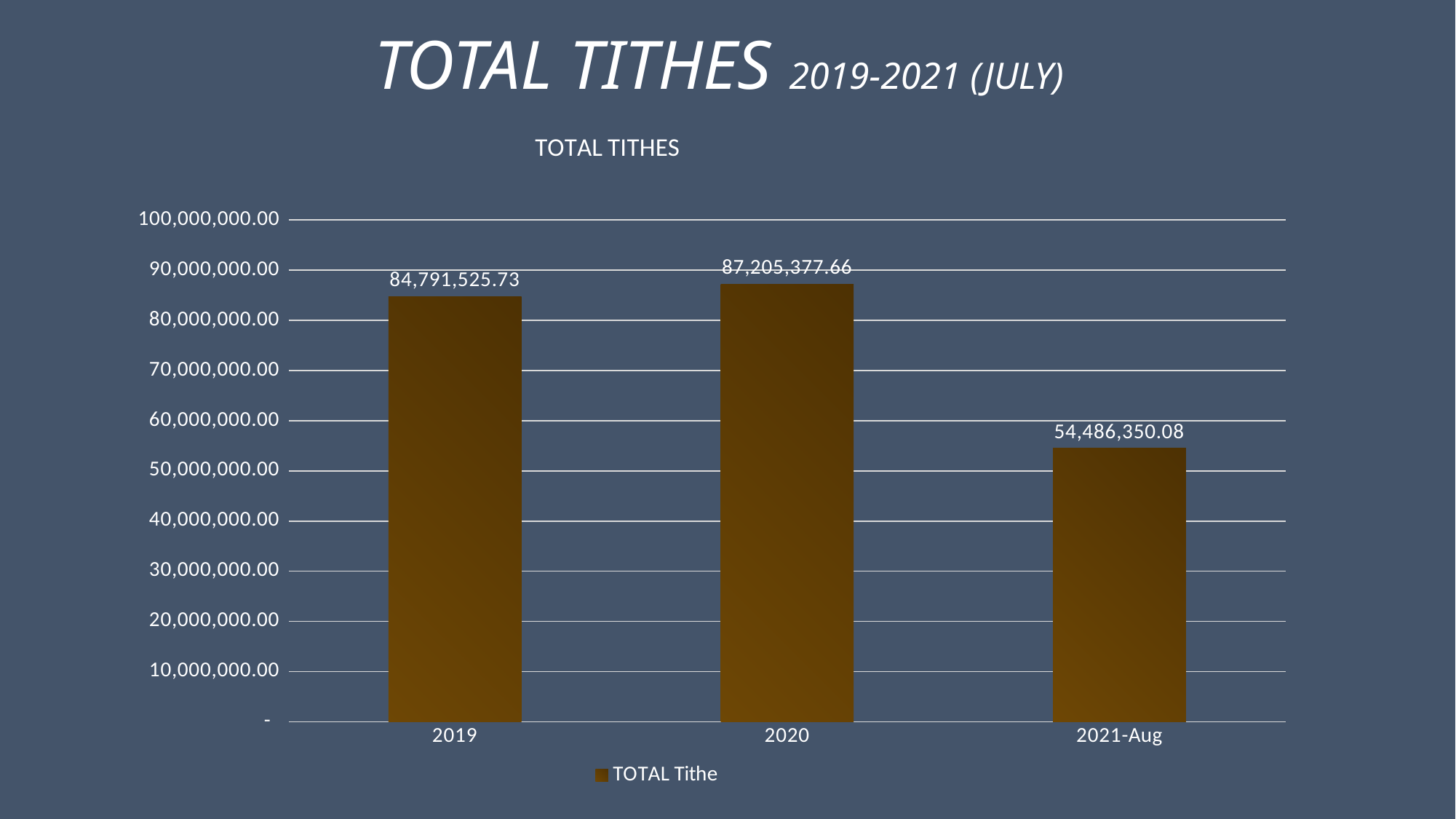
What is the value for 2019? 84,791,525.73 How many categories are shown on the x axis? 3 What is the value for 2020? 87,205,377.66 Which category has the highest value? 2020 What is the value for 2021-Aug? 54,486,350.08 Is the value for 2021-Aug greater or less than 60,000,000.00? less What series name does the legend show? TOTAL Tithe What is the difference between the values for 2020 and 2021-Aug? 32,719,027.58 Which category has the lowest value? 2021-Aug What is the difference between the values for 2020 and 2019? 2,413,851.93 Which is larger, the value for 2019 or the value for 2021-Aug? 2019 What kind of chart is shown? bar chart